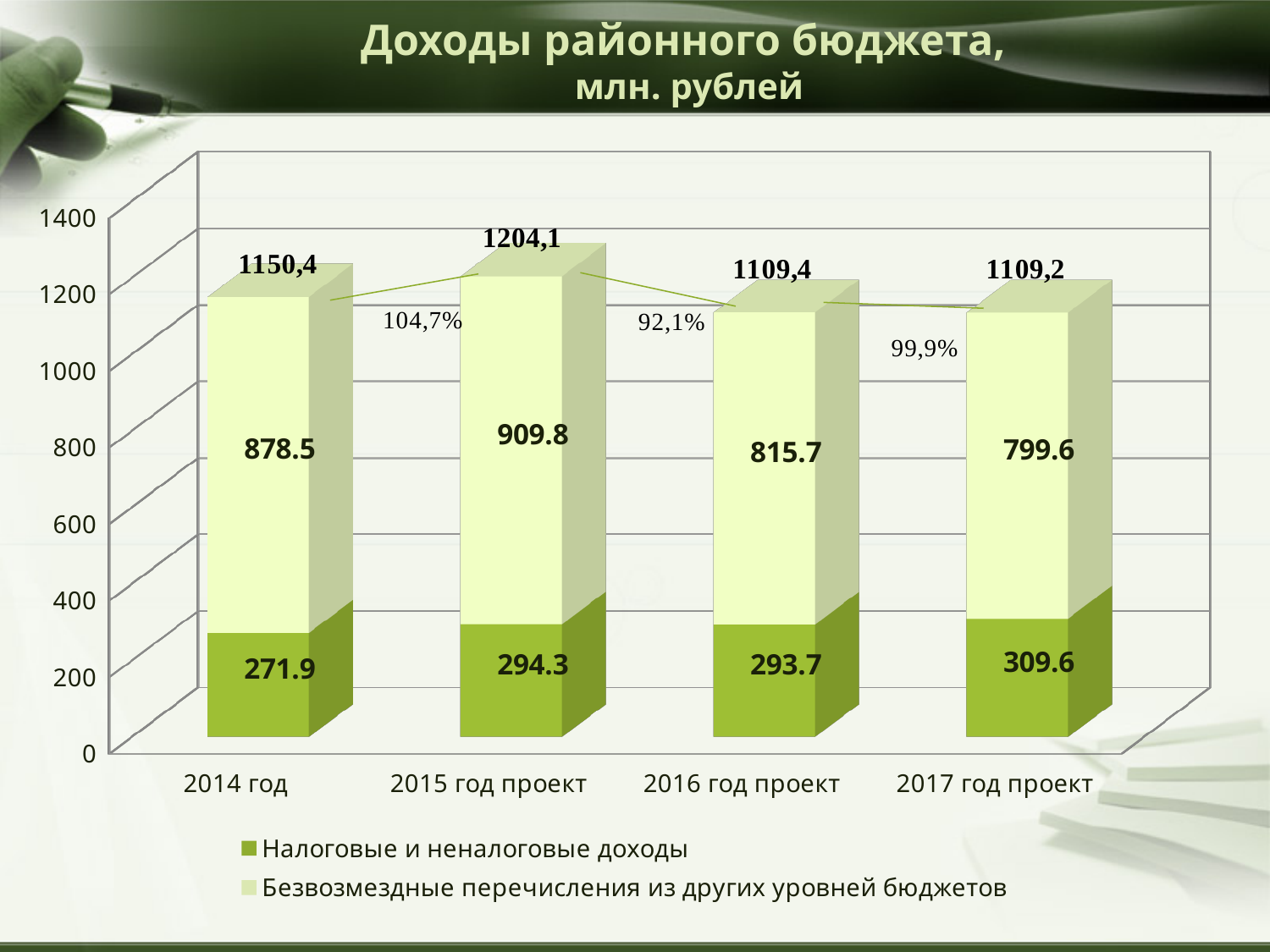
What is the value of Безвозмездные перечисления из других уровней бюджетов for 2015 год проект? 909.8 What is the value of Налоговые и неналоговые доходы for 2017 год проект? 309.6 What percentage is printed between the 2015 год проект and 2016 год проект bars? 92,1% What is the total printed above the bar for 2016 год проект? 1109,4 What kind of chart is shown on the slide? Stacked bar chart How many series does the legend list? 2 What is the value of Налоговые и неналоговые доходы for 2014 год? 271.9 Which year has the highest value for Безвозмездные перечисления из других уровней бюджетов? 2015 год проект Which is larger: Налоговые и неналоговые доходы for 2015 год проект or for 2016 год проект? 2015 год проект How many categories (years) are shown on the x axis? 4 Which year has the lowest value for Налоговые и неналоговые доходы? 2014 год What is the difference between the Безвозмездные перечисления values for 2015 год проект and 2016 год проект? 94.1